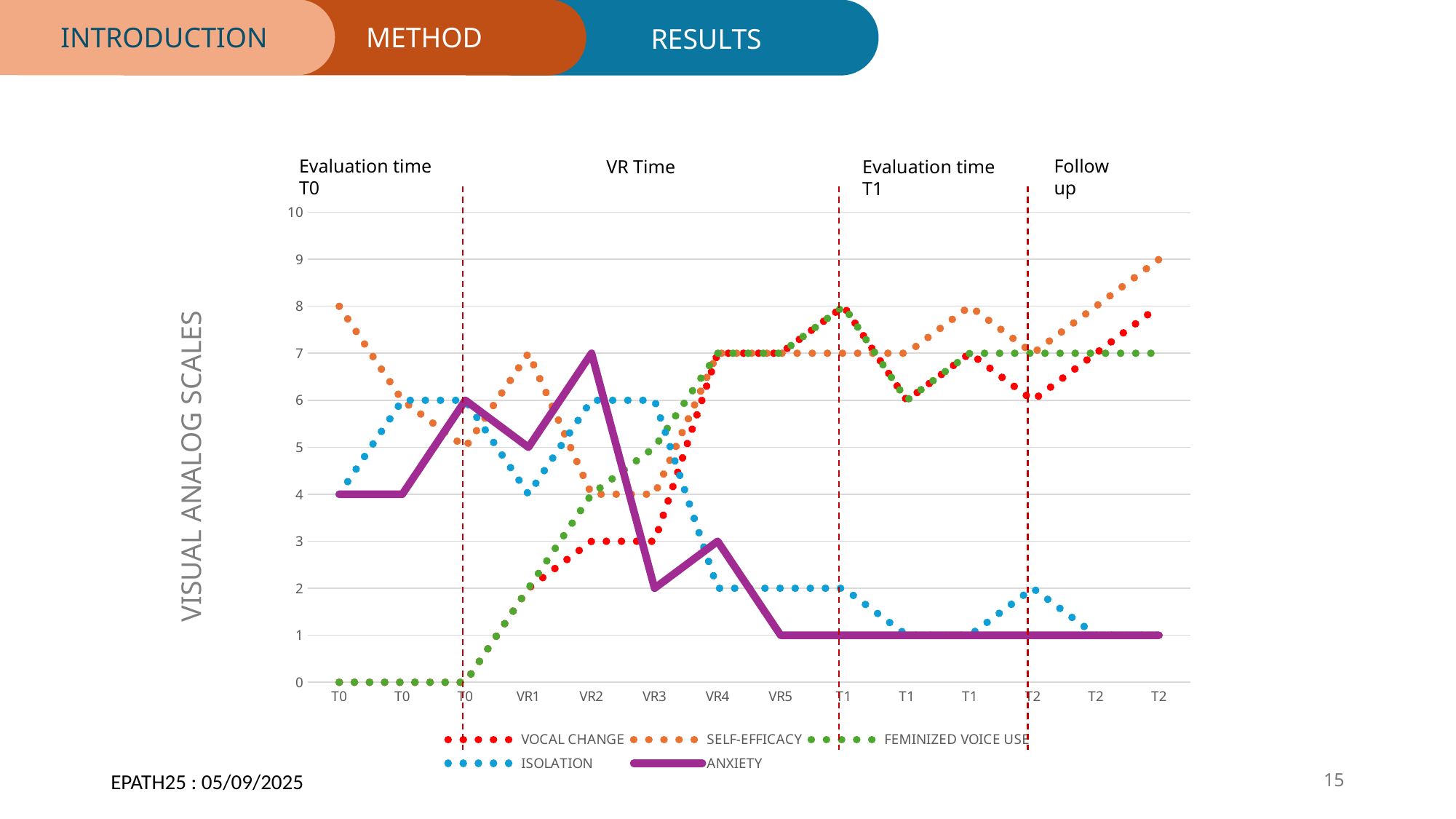
What is the value of ANXIETY at VR2? 7 What kind of chart is shown on the slide? line chart At which x-axis point does ANXIETY reach its highest value? VR2 Does FEMINIZED VOICE USE rise or fall from T0 to VR4? rise How many points are there along the x axis? 14 What is the value of SELF-EFFICACY at the last T2 point? 9 At the first T0 point, which is larger: SELF-EFFICACY or ISOLATION? SELF-EFFICACY What is the label on the vertical axis of the chart? VISUAL ANALOG SCALES Is the value for ANXIETY at VR3 greater or less than 5? less What is the value of ANXIETY at VR5? 1 What is the value of FEMINIZED VOICE USE at the first T0 point? 0 How many series does the legend list? 5